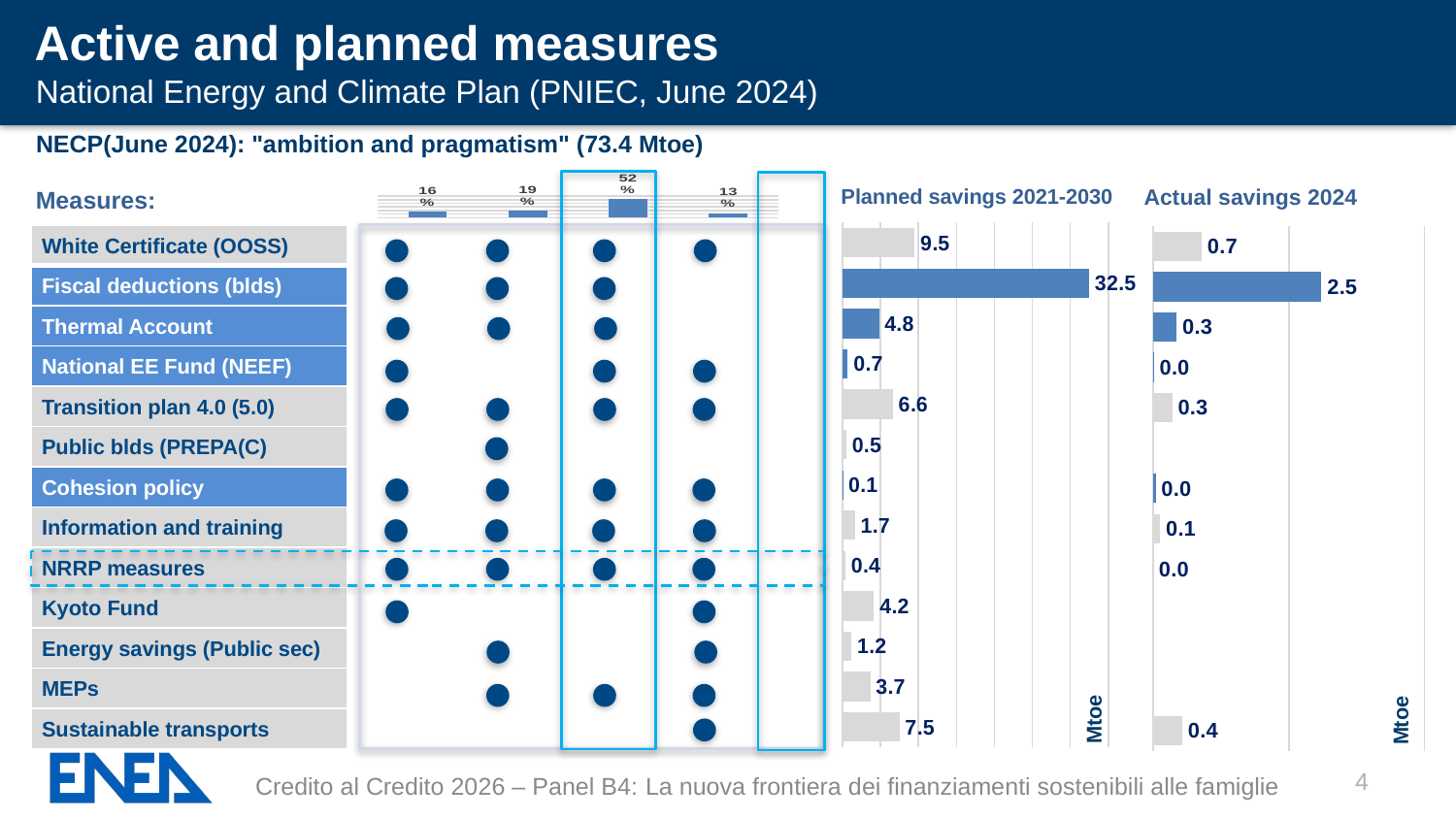
In the 'Planned savings 2021-2030' chart, which measure has the lowest value? Cohesion policy In the 'Planned savings 2021-2030' chart, what is the value for Fiscal deductions (blds)? 32.5 In the 'Planned savings 2021-2030' chart, what is the difference between the values for White Certificate (OOSS) and Transition plan 4.0 (5.0)? 2.9 In the 'Actual savings 2024' chart, which measure has the highest value? Fiscal deductions (blds) In the 'Actual savings 2024' chart, which is larger: the value for Thermal Account or the value for Information and training? Thermal Account In the 'Actual savings 2024' chart, what is the value for Fiscal deductions (blds)? 2.5 In the 'Actual savings 2024' chart, what is the value for White Certificate (OOSS)? 0.7 What kind of chart is the 'Planned savings 2021-2030' chart? Bar chart In the 'Planned savings 2021-2030' chart, which measure has the highest value? Fiscal deductions (blds) In the 'Planned savings 2021-2030' chart, which is larger: the value for Kyoto Fund or the value for MEPs? Kyoto Fund What unit is shown on the axis of the 'Actual savings 2024' chart? Mtoe In the 'Planned savings 2021-2030' chart, what is the value for Sustainable transports? 7.5